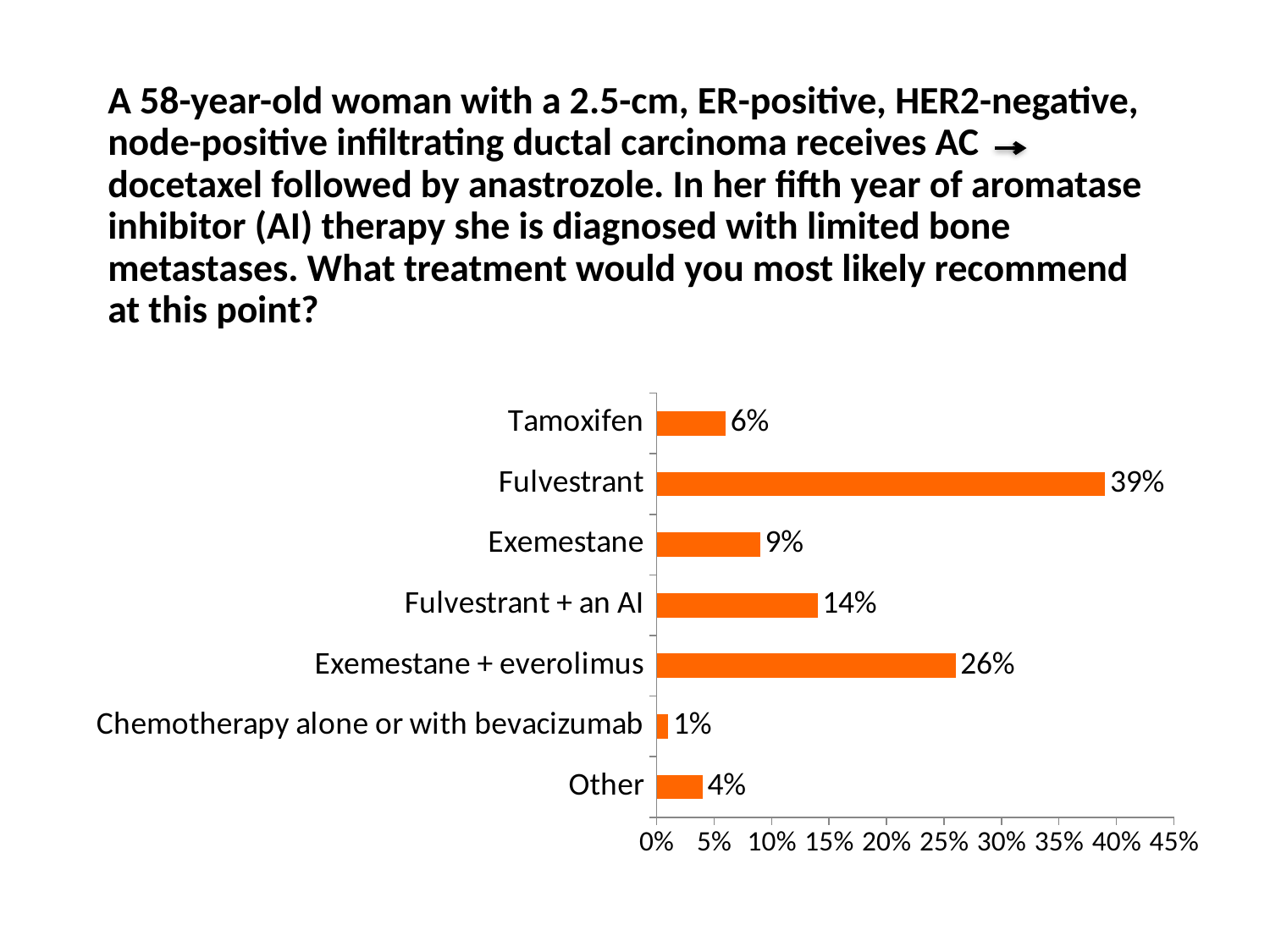
Is the value for fulvestrant greater or less than 35%? greater What is the maximum value shown on the percentage axis? 45% What percentage is shown for fulvestrant + an AI? 14% What type of chart is shown on the slide? Bar chart Which treatment option has the lowest percentage? Chemotherapy alone or with bevacizumab How many treatment options are shown in the chart? 7 What is the value shown for exemestane + everolimus? 26% What is the value for chemotherapy alone or with bevacizumab? 1% Which treatment option has the highest percentage? Fulvestrant What is the difference in percentage points between fulvestrant and exemestane + everolimus? 13 Which has a higher value, exemestane or tamoxifen? Exemestane What percentage of respondents would recommend fulvestrant? 39%